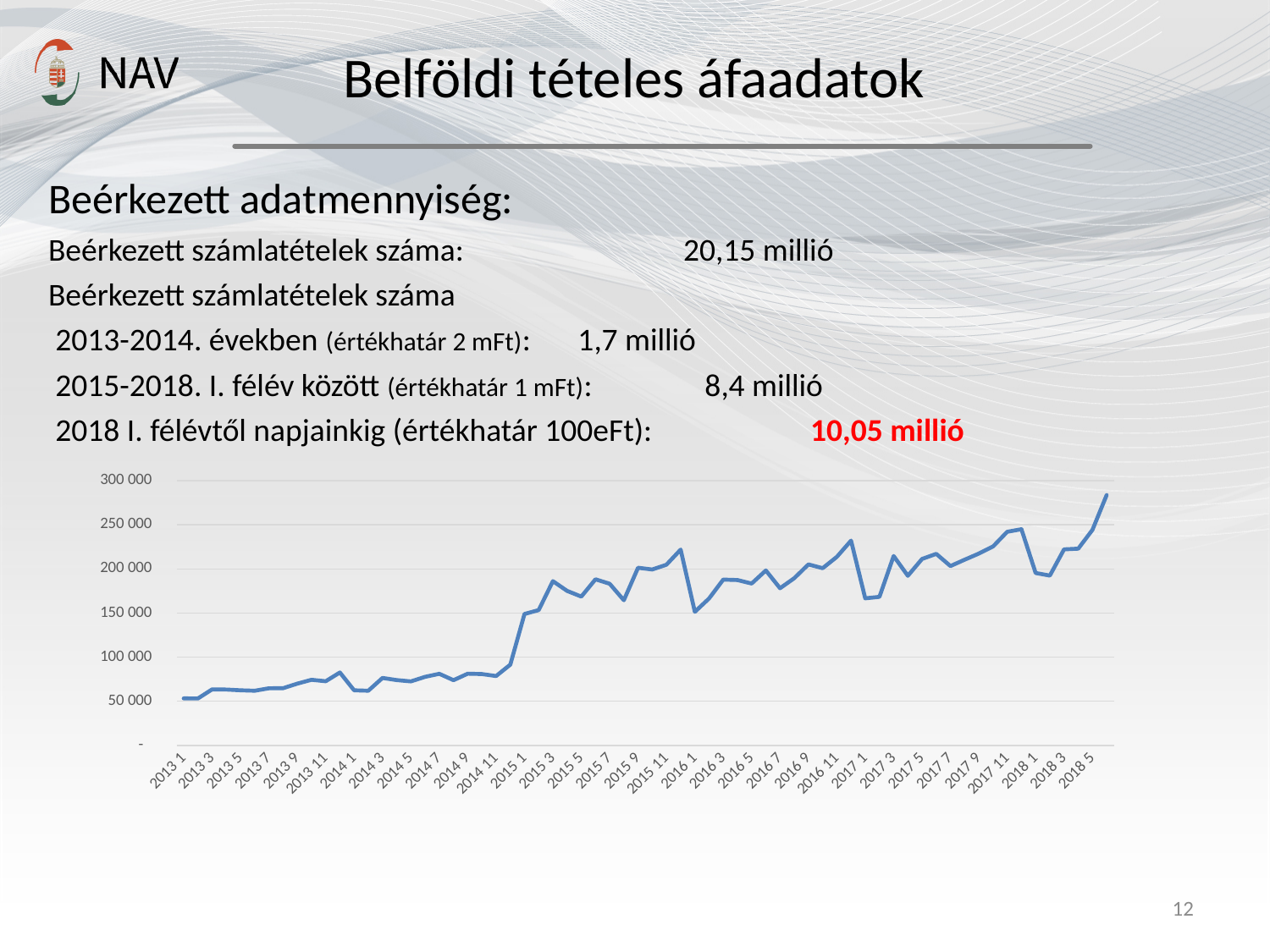
What is the first label on the horizontal axis of the chart? 2013 1 Which is larger, the value for 2017 11 or the value for 2018 1? 2017 11 Is the value for 2017 11 greater or less than 200 000? greater What kind of chart is shown on the slide? line chart Which is larger, the value for 2015 1 or the value for 2014 11? 2015 1 Is the value for 2015 1 greater or less than 100 000? greater Overall, do the values on the chart rise or fall from 2013 1 to 2018 5? rise Is the value for 2014 11 greater or less than 100 000? less What is the highest tick value shown on the vertical axis of the chart? 300 000